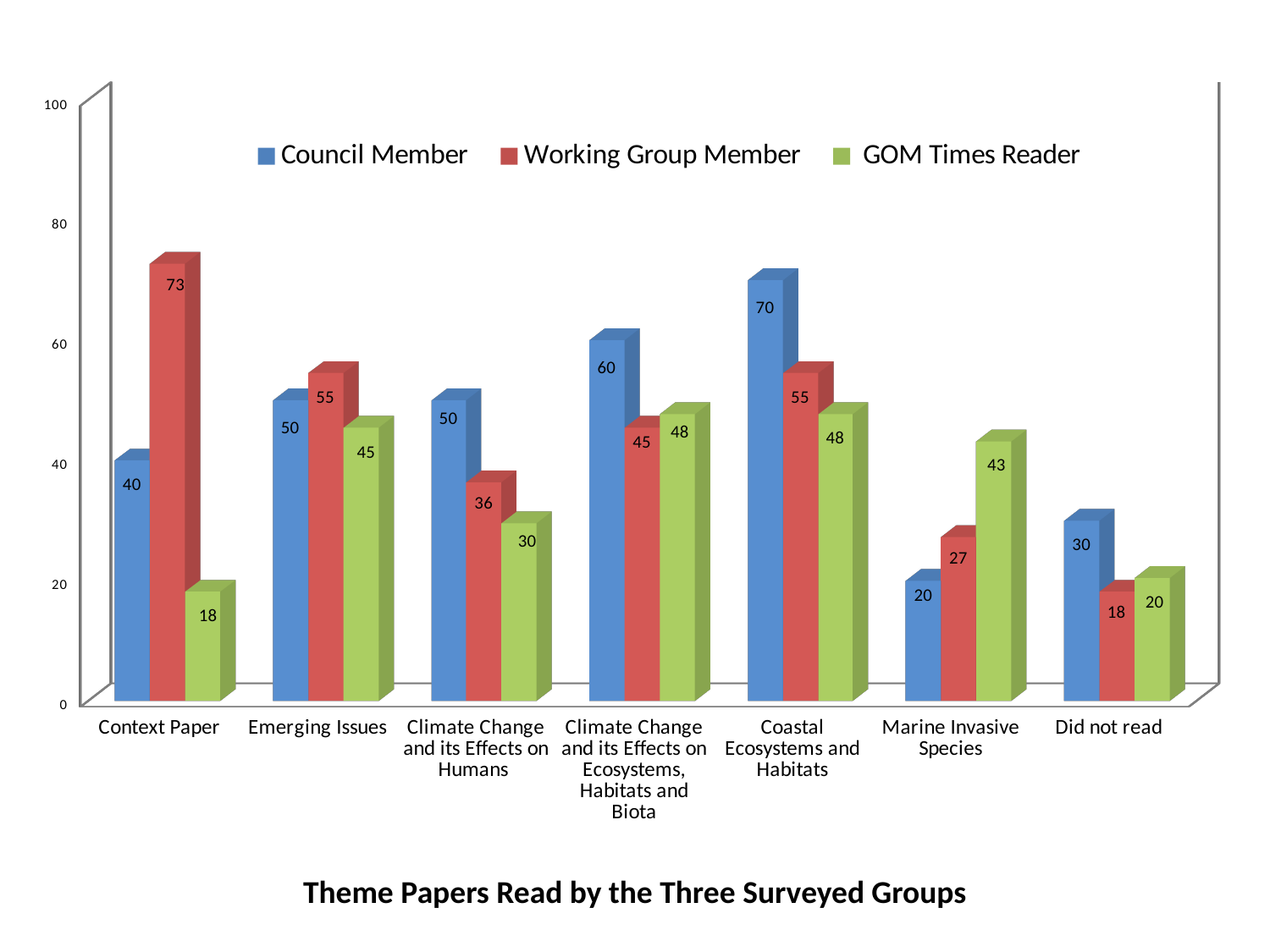
What is the value for Working Group Member on Context Paper? 73 How many categories are shown on the x axis? 7 What kind of chart is shown on the slide? bar chart Which category has the lowest value for GOM Times Reader? Context Paper Which category has the highest value for Council Member? Coastal Ecosystems and Habitats What is the title of the chart? Theme Papers Read by the Three Surveyed Groups Is the value for Council Member on Climate Change and its Effects on Ecosystems, Habitats and Biota greater or less than 40? greater What is the value for Council Member on Coastal Ecosystems and Habitats? 70 Which is larger for Marine Invasive Species: Council Member or GOM Times Reader? GOM Times Reader What is the value for GOM Times Reader on Marine Invasive Species? 43 What is the difference between the Working Group Member and GOM Times Reader values for Context Paper? 55 How many series does the legend list? 3